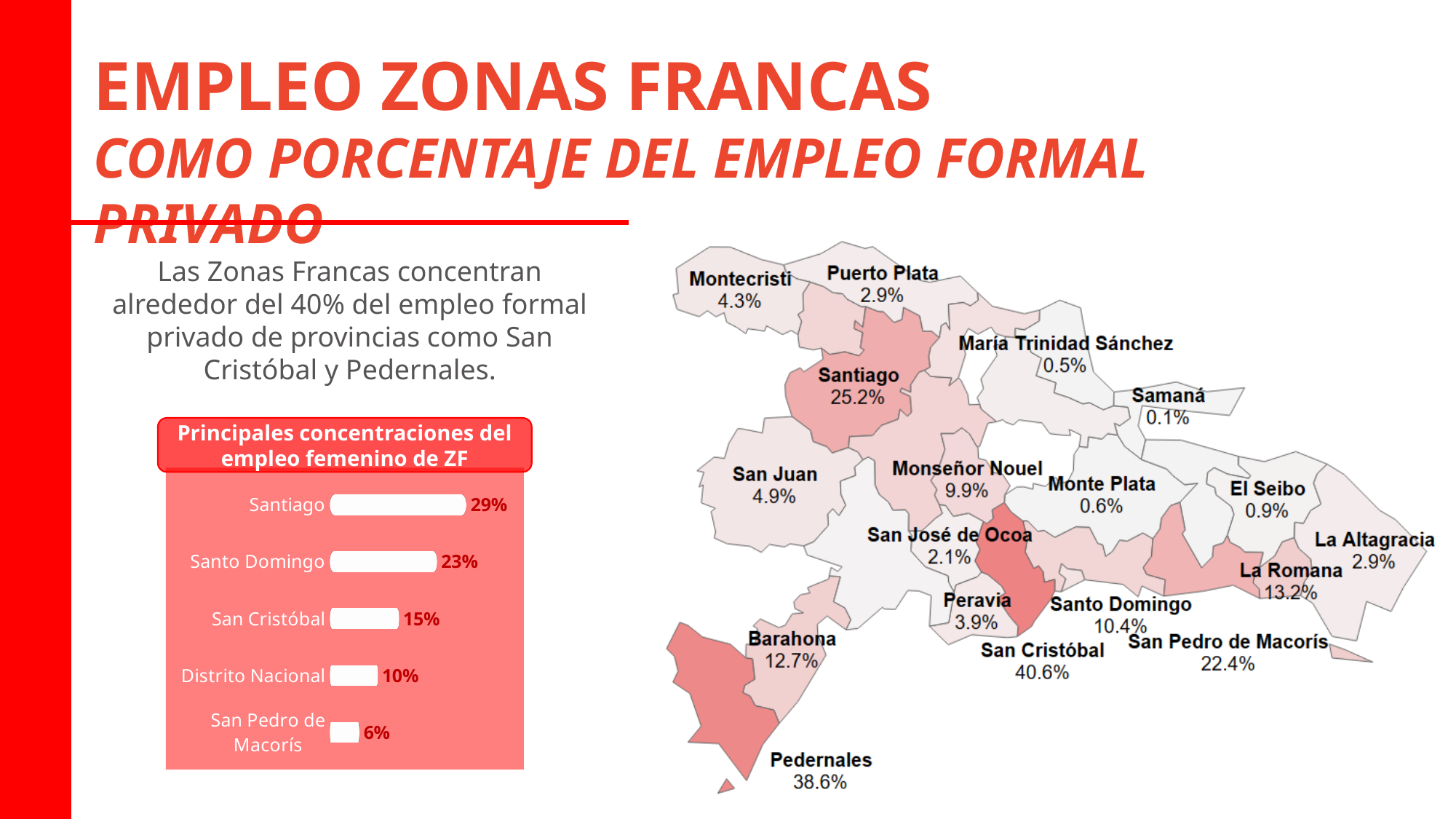
In the bar chart 'Principales concentraciones del empleo femenino de ZF', which is larger, Distrito Nacional or San Cristóbal? San Cristóbal On the map on the right, what percentage is shown for San Cristóbal? 40.6% In the bar chart 'Principales concentraciones del empleo femenino de ZF', what is the difference between Santiago and Santo Domingo? 6% On the map on the right, which is larger, Santiago or La Romana? Santiago What kind of chart is 'Principales concentraciones del empleo femenino de ZF'? Bar chart In the bar chart 'Principales concentraciones del empleo femenino de ZF', do the values rise or fall from top to bottom? Fall On the map on the right, what percentage is shown for Pedernales? 38.6% In the bar chart 'Principales concentraciones del empleo femenino de ZF', which category has the lowest value? San Pedro de Macorís How many categories does the bar chart 'Principales concentraciones del empleo femenino de ZF' show? 5 In the bar chart 'Principales concentraciones del empleo femenino de ZF', which category has the highest value? Santiago In the bar chart 'Principales concentraciones del empleo femenino de ZF', what is the value for San Cristóbal? 15% In the bar chart 'Principales concentraciones del empleo femenino de ZF', what is the value for Santiago? 29%